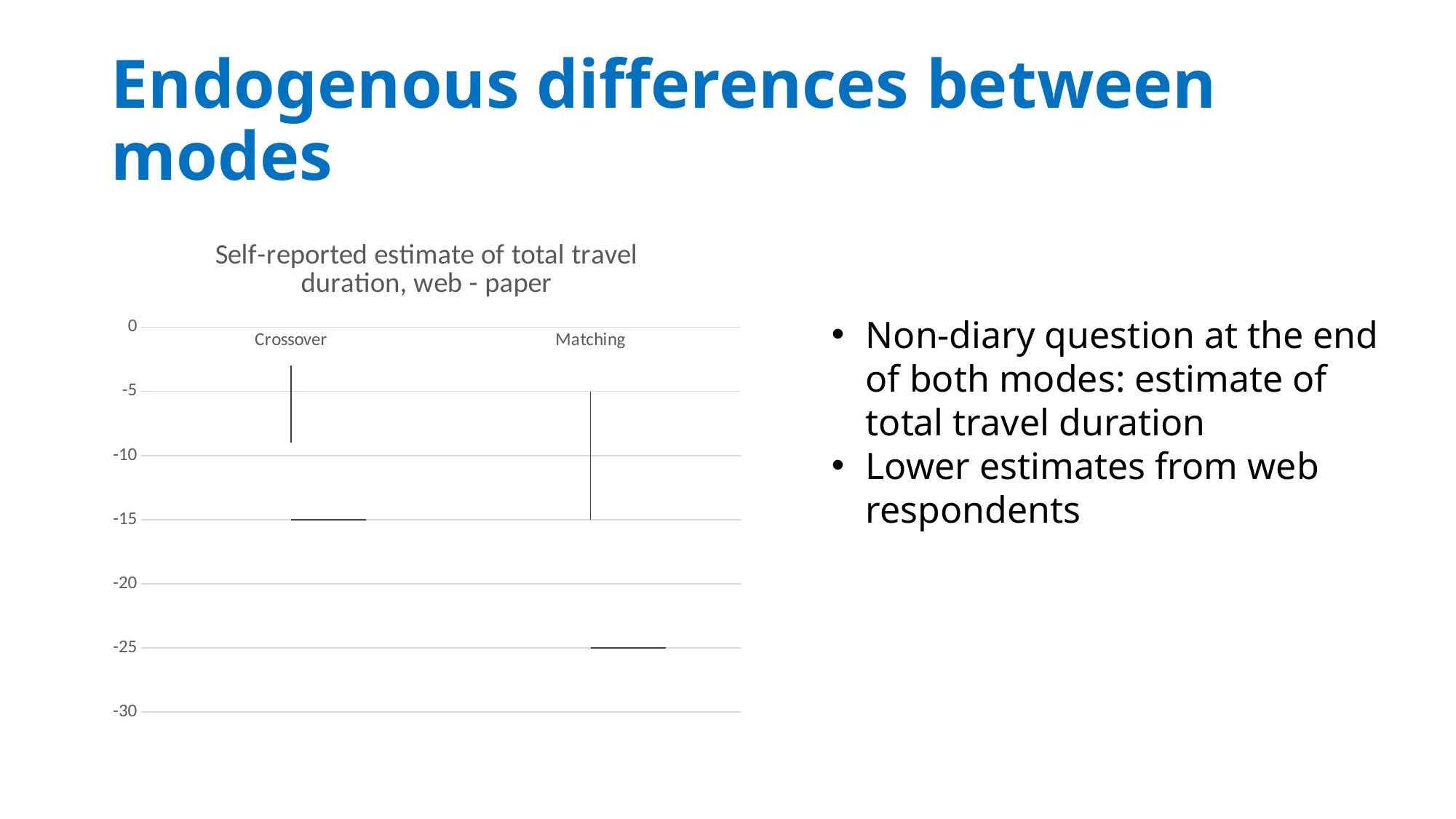
At what value does the horizontal marker for Matching sit? -25 Do the horizontal marker values rise or fall from Crossover to Matching? fall Which category has the lower horizontal marker value, Crossover or Matching? Matching What is the title of the chart? Self-reported estimate of total travel duration, web - paper Is the horizontal marker value for Crossover greater or less than -10? less What are the two categories shown on the x axis of the chart? Crossover and Matching Which category has the lowest horizontal marker value? Matching Is the horizontal marker value for Matching greater or less than -20? less What is the difference between the horizontal marker values for Crossover (-15) and Matching (-25)? 10 At what value does the horizontal marker for Crossover sit? -15 How many categories are shown on the x axis of the chart? 2